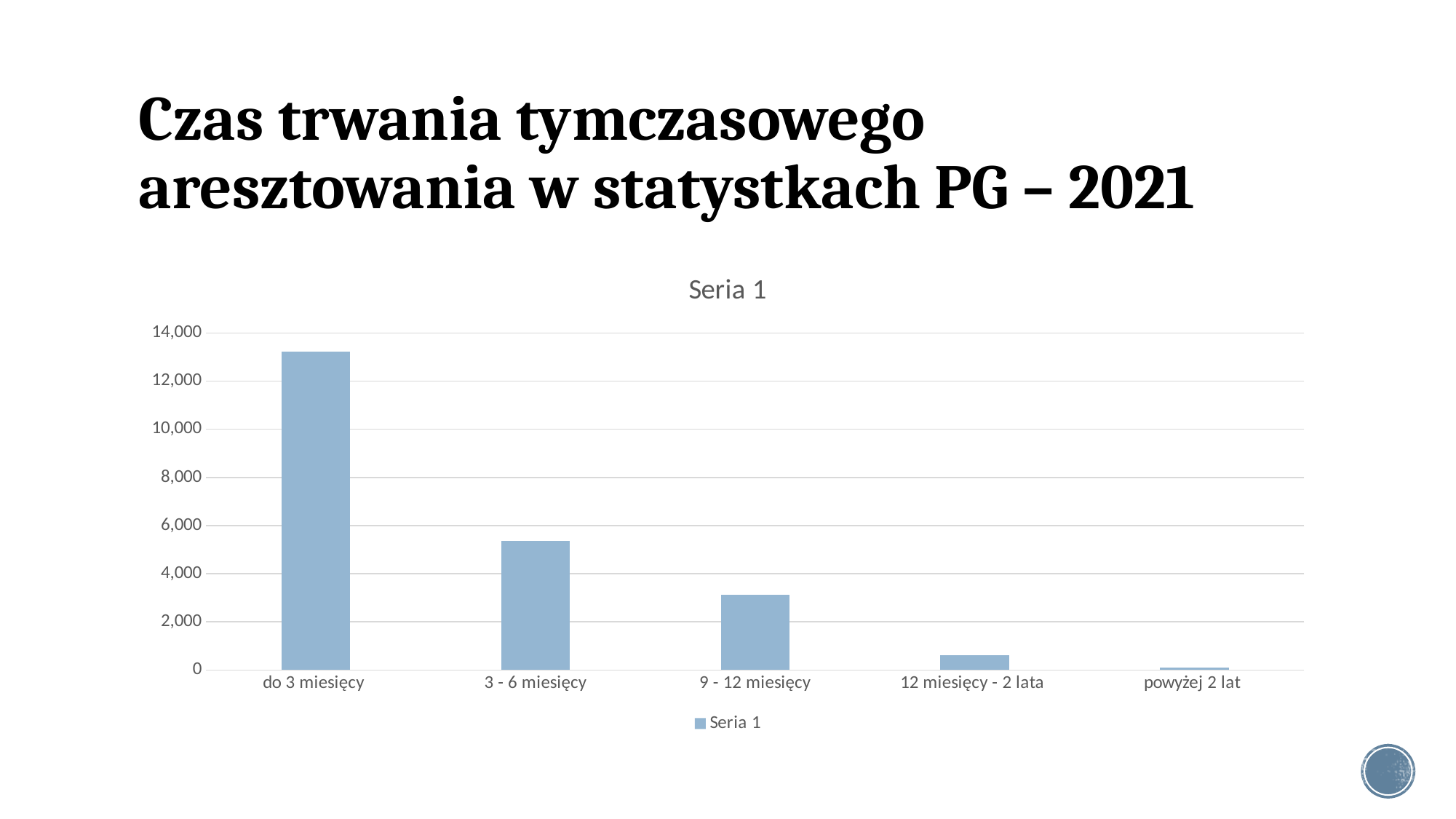
Which category has the highest value in the chart? do 3 miesięcy Do the values rise or fall moving from left to right along the x axis? fall How many series does the chart legend list? 1 Is the value for '9 - 12 miesięcy' greater or less than 2,000? greater Which is larger, the value for '3 - 6 miesięcy' or the value for '9 - 12 miesięcy'? 3 - 6 miesięcy Which category has the lowest value in the chart? powyżej 2 lat Is the value for '12 miesięcy - 2 lata' greater or less than 2,000? less What is the name of the series shown in the chart legend? Seria 1 How many categories are shown on the x axis of the chart? 5 Is the value for 'do 3 miesięcy' greater or less than 12,000? greater What kind of chart is shown on the slide? bar chart